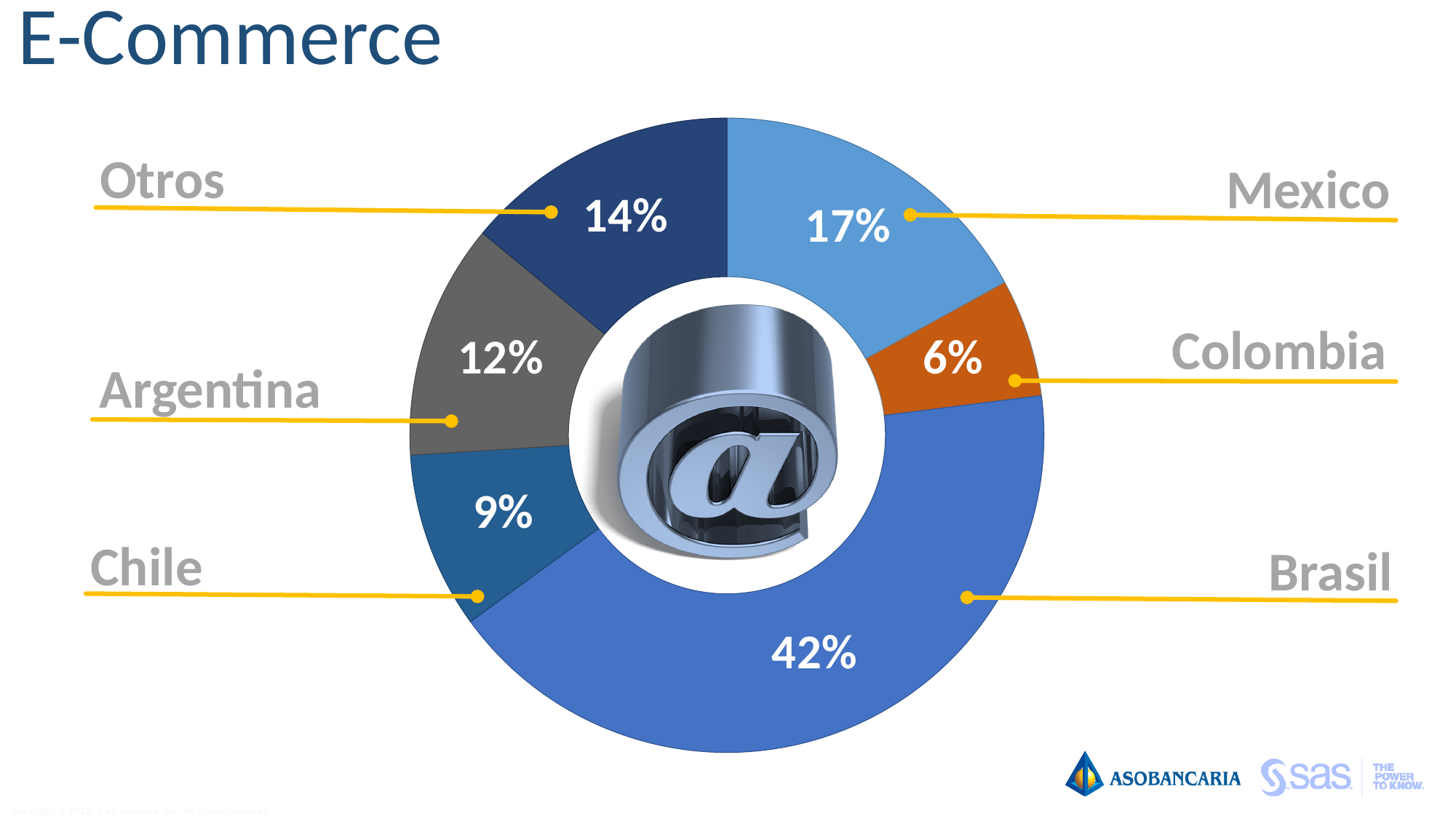
What share of the pie does Brasil have? 42% Which category has the largest share of the pie? Brasil What is the difference between the shares of Brasil and Mexico? 25% What share of the pie does Chile have? 9% How many categories are shown in the pie chart? 6 What kind of chart is shown on the slide? Doughnut chart What share of the pie does Argentina have? 12% What share of the pie does Colombia have? 6% Which category has the smallest share of the pie? Colombia What share of the pie does Otros have? 14% What share of the pie does Mexico have? 17% Which has a larger share, Argentina or Chile? Argentina